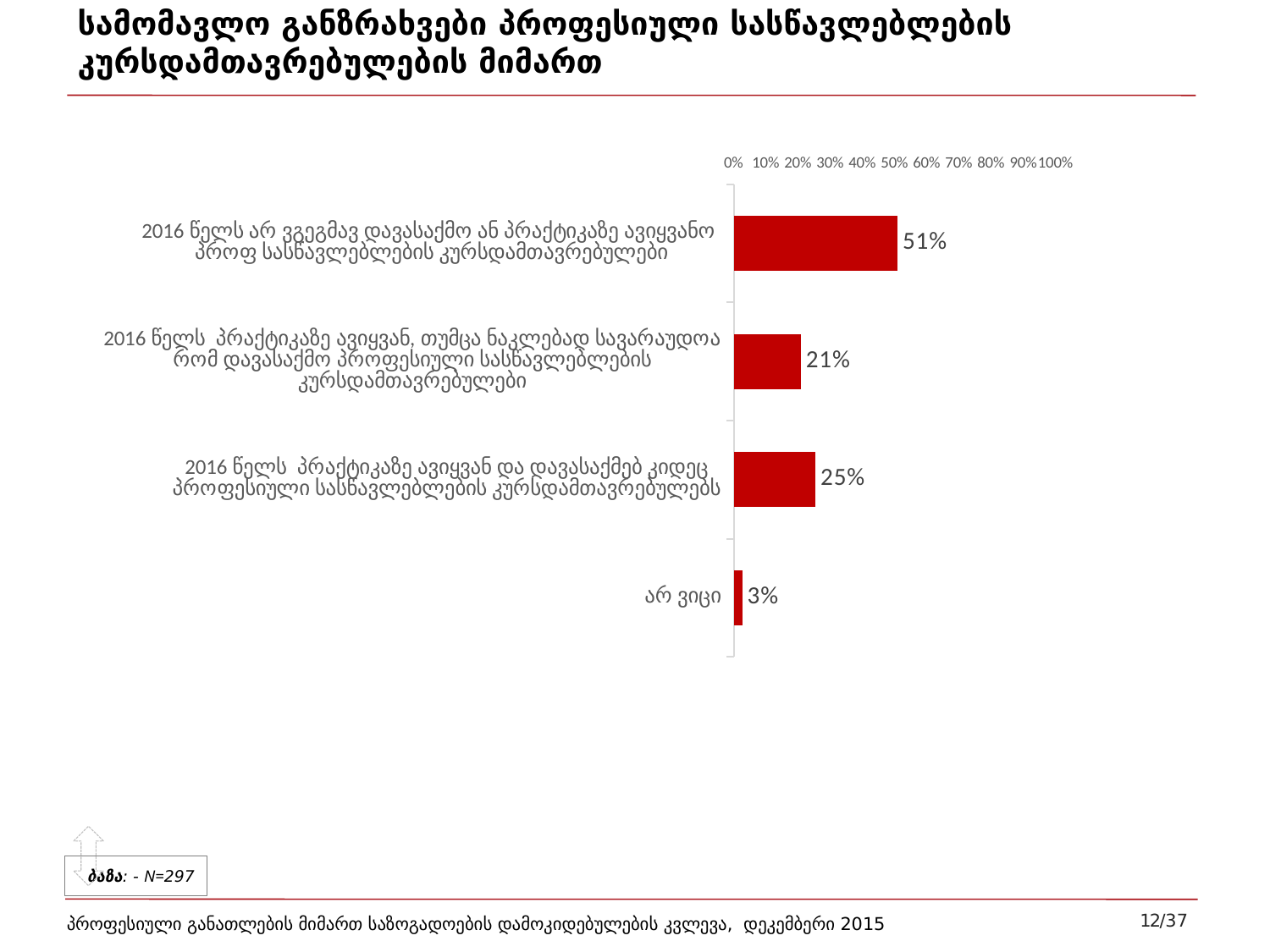
Which category has the highest value? 2016 წელს არ ვგეგმავ დავასაქმო ან პრაქტიკაზე ავიყვანო პროფ სასწავლებლების კურსდამთავრებულები What is the value for the category "2016 წელს პრაქტიკაზე ავიყვან და დავასაქმებ კიდეც პროფესიული სასწავლებლების კურსდამთავრებულები"? 25% What is the value for the category "2016 წელს არ ვგეგმავ დავასაქმო ან პრაქტიკაზე ავიყვანო პროფ სასწავლებლების კურსდამთავრებულები"? 51% Which category has the lowest value? არ ვიცი How many categories are shown in the chart? 4 What kind of chart is shown on the slide? bar chart What is the value for the category "2016 წელს პრაქტიკაზე ავიყვან, თუმცა ნაკლებად სავარაუდოა რომ დავასაქმო პროფესიული სასწავლებლების კურსდამთავრებულები"? 21% What is the value for the category "არ ვიცი"? 3% Which is larger: the value for "2016 წელს პრაქტიკაზე ავიყვან და დავასაქმებ კიდეც..." or the value for "2016 წელს პრაქტიკაზე ავიყვან, თუმცა ნაკლებად სავარაუდოა რომ დავასაქმო..."? 2016 წელს პრაქტიკაზე ავიყვან და დავასაქმებ კიდეც პროფესიული სასწავლებლების კურსდამთავრებულები What is the difference between the value for "2016 წელს პრაქტიკაზე ავიყვან და დავასაქმებ კიდეც..." and the value for "2016 წელს პრაქტიკაზე ავიყვან, თუმცა ნაკლებად სავარაუდოა რომ დავასაქმო..."? 4% Is the value for "2016 წელს არ ვგეგმავ დავასაქმო ან პრაქტიკაზე ავიყვანო..." greater or less than 50%? greater What is the difference between the value for "2016 წელს არ ვგეგმავ დავასაქმო ან პრაქტიკაზე ავიყვანო..." (51%) and the value for "არ ვიცი" (3%)? 48%